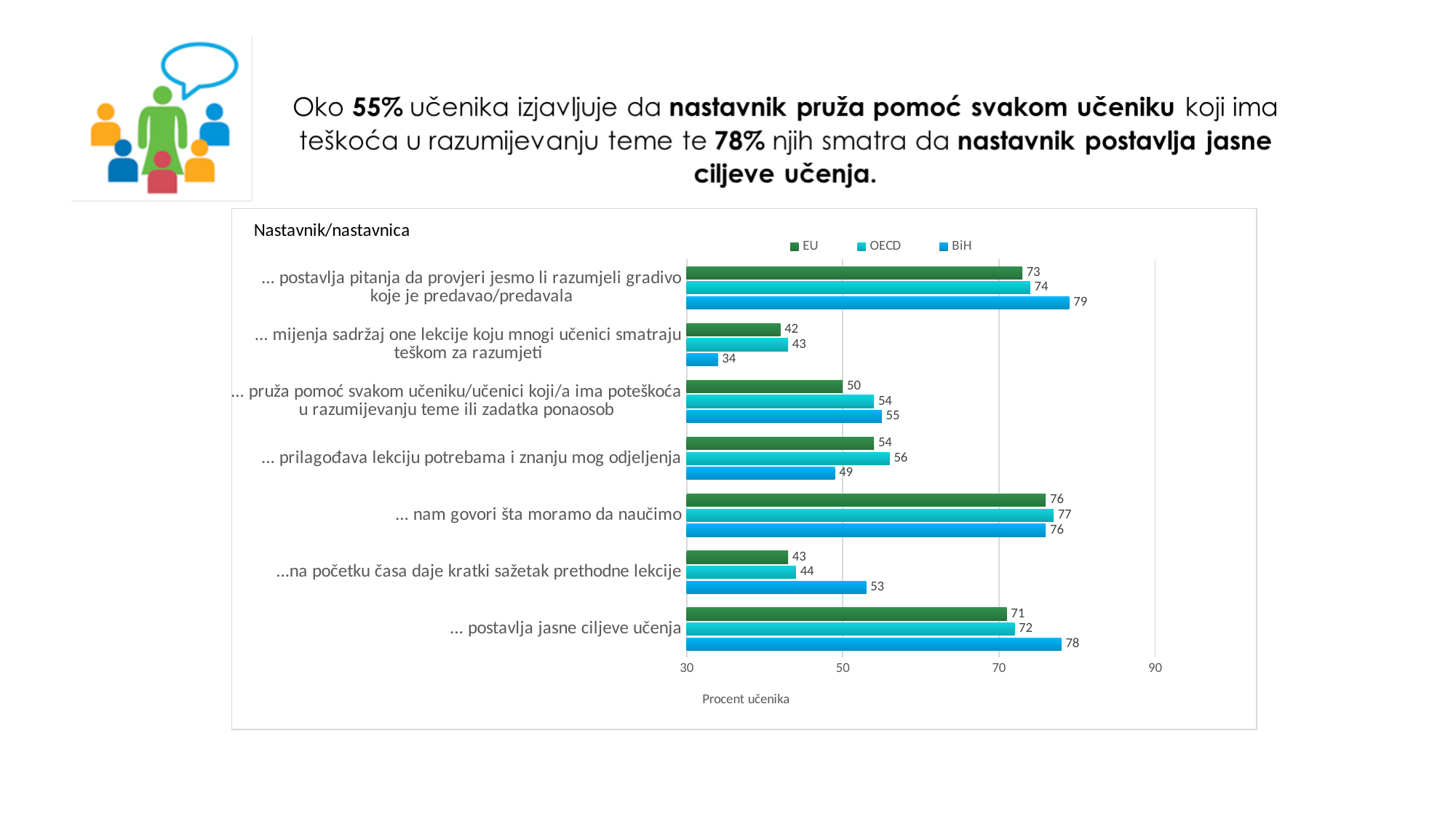
What kind of chart is shown on the slide? bar chart For "... prilagođava lekciju potrebama i znanju mog odjeljenja", which is larger: the OECD value or the BiH value? OECD What is the OECD value for "... prilagođava lekciju potrebama i znanju mog odjeljenja"? 56 How many series does the legend list? 3 What is the difference between the BiH and EU values for "...na početku časa daje kratki sažetak prethodne lekcije"? 10 Is the BiH value for "... pruža pomoć svakom učeniku/učenici koji/a ima poteškoća u razumijevanju teme ili zadatka ponaosob" greater or less than 50? greater How many categories are shown on the chart? 7 What is the BiH value for "... postavlja jasne ciljeve učenja"? 78 Which category has the lowest BiH value? ... mijenja sadržaj one lekcije koju mnogi učenici smatraju teškom za razumjeti What is the label of the horizontal axis? Procent učenika Which category has the highest BiH value? ... postavlja pitanja da provjeri jesmo li razumjeli gradivo koje je predavao/predavala What is the EU value for "... mijenja sadržaj one lekcije koju mnogi učenici smatraju teškom za razumjeti"? 42